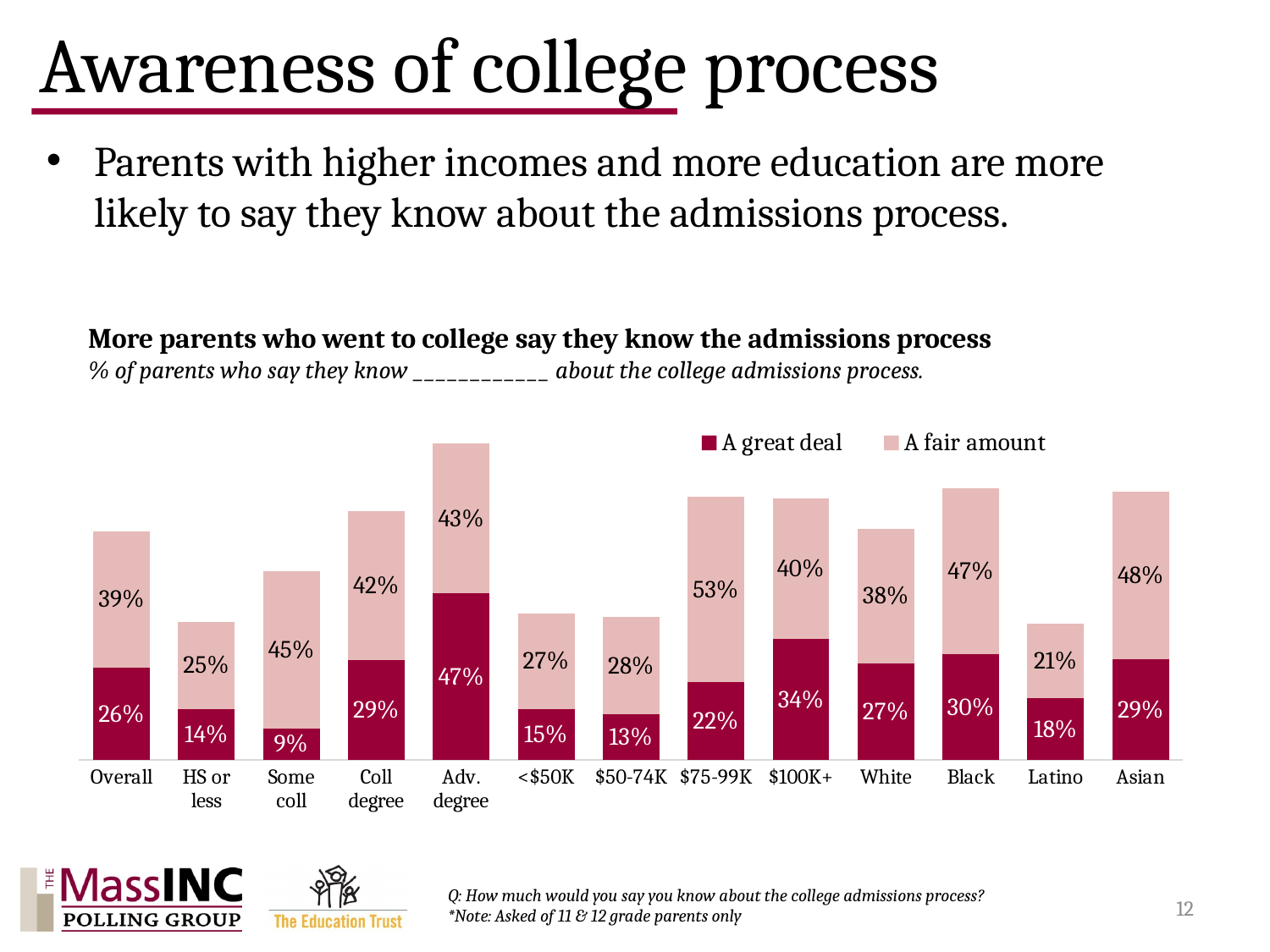
What kind of chart is shown on the slide? Stacked bar chart What is the total of the stacked bar for HS or less? 39% What is the total of the stacked bar for Adv. degree? 90% How many categories are shown along the x axis? 13 Which is larger, the 'A fair amount' value for Black or for White? Black How many series does the legend list? 2 What is the value of 'A great deal' for Adv. degree? 47% Which category has the lowest value for 'A great deal'? Some coll What is the value of 'A fair amount' for $75-99K? 53% Which category has the highest value for 'A great deal'? Adv. degree Which category has the lowest value for 'A fair amount'? Latino What is the difference between the 'A great deal' values for $100K+ and <$50K? 19%